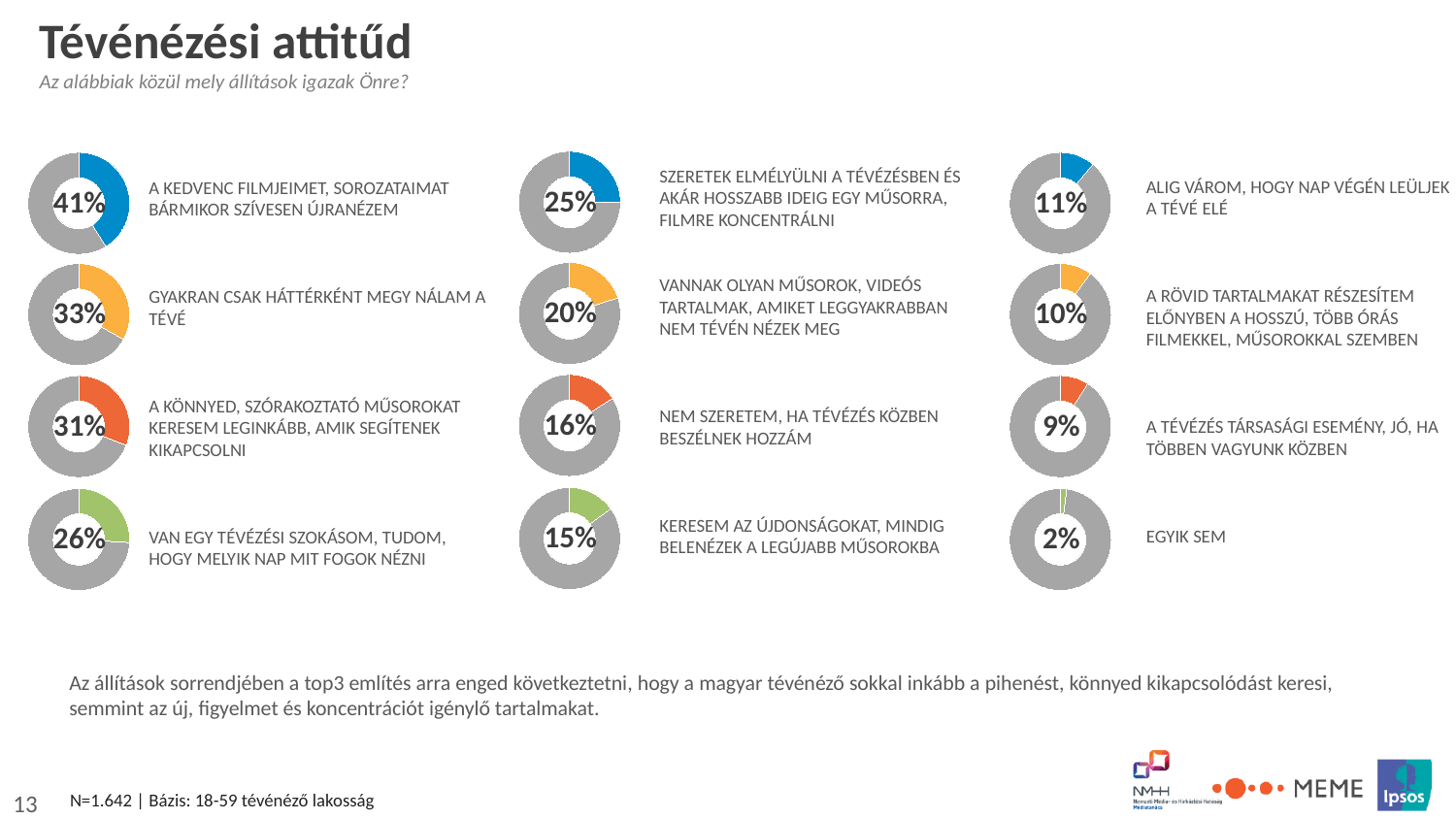
What type of chart is used to display each percentage on the slide? Donut chart Which is larger: the percentage for "Van egy tévézési szokásom, tudom, hogy melyik nap mit fogok nézni" or the percentage for "Szeretek elmélyülni a tévézésben és akár hosszabb ideig egy műsorra, filmre koncentrálni"? Van egy tévézési szokásom, tudom, hogy melyik nap mit fogok nézni Which statement has the highest percentage among all the donut charts on the slide? A kedvenc filmjeimet, sorozataimat bármikor szívesen újranézem What percentage is shown in the donut chart for the statement "A kedvenc filmjeimet, sorozataimat bármikor szívesen újranézem"? 41% What percentage is shown in the donut chart for the statement "Alig várom, hogy nap végén leüljek a tévé elé"? 11% What is the title of the slide containing the donut charts? Tévénézési attitűd How many donut charts are shown on the slide? 12 What percentage is shown in the donut chart for the statement "Nem szeretem, ha tévézés közben beszélnek hozzám"? 16% What percentage is shown in the donut chart for the statement "Egyik sem"? 2% What is the difference between the percentage for "A kedvenc filmjeimet, sorozataimat bármikor szívesen újranézem" and the percentage for "Gyakran csak háttérként megy nálam a tévé"? 8% Which statement has the lowest percentage among all the donut charts on the slide? Egyik sem What percentage is shown in the donut chart for the statement "Gyakran csak háttérként megy nálam a tévé"? 33%